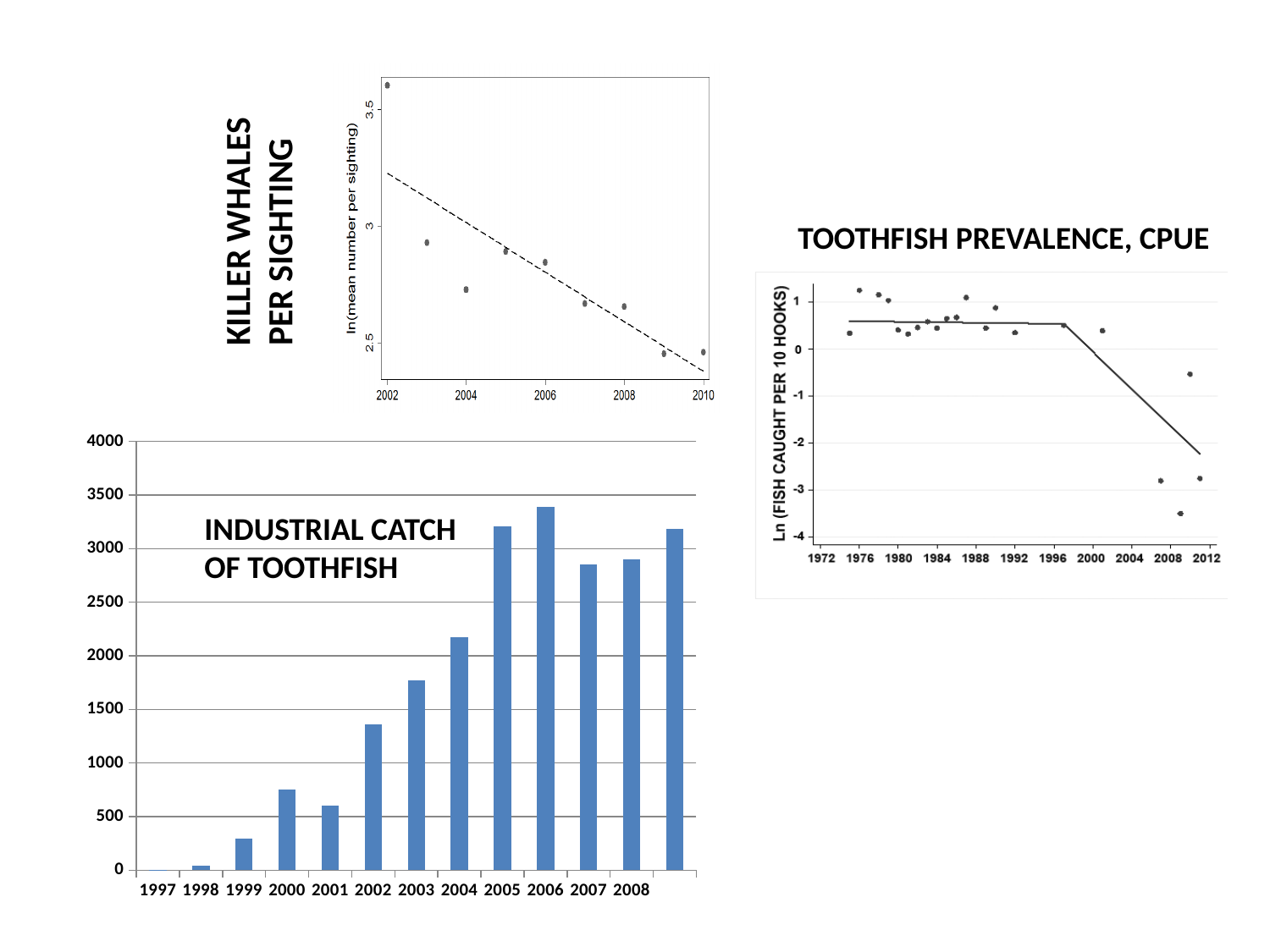
In the Industrial Catch of Toothfish chart, is the value for 2006 greater or less than 3000? greater In the Industrial Catch of Toothfish chart, do the values generally rise or fall from 1997 to 2006? rise In the Industrial Catch of Toothfish chart, which is larger, the bar for 2005 or the bar for 2007? 2005 In the Industrial Catch of Toothfish chart, which labelled year has the lowest bar? 1997 In the Industrial Catch of Toothfish chart, is the value for 2007 greater or less than 3000? less In the Industrial Catch of Toothfish chart, which labelled year has the highest bar? 2006 What is the y-axis label of the Toothfish Prevalence, CPUE chart? Ln (FISH CAUGHT PER 10 HOOKS) In the Industrial Catch of Toothfish chart, is the value for 1999 greater or less than 500? less What kind of chart is the Industrial Catch of Toothfish chart? bar chart In the Killer Whales Per Sighting chart, do the values generally rise or fall from 2002 to 2010? fall